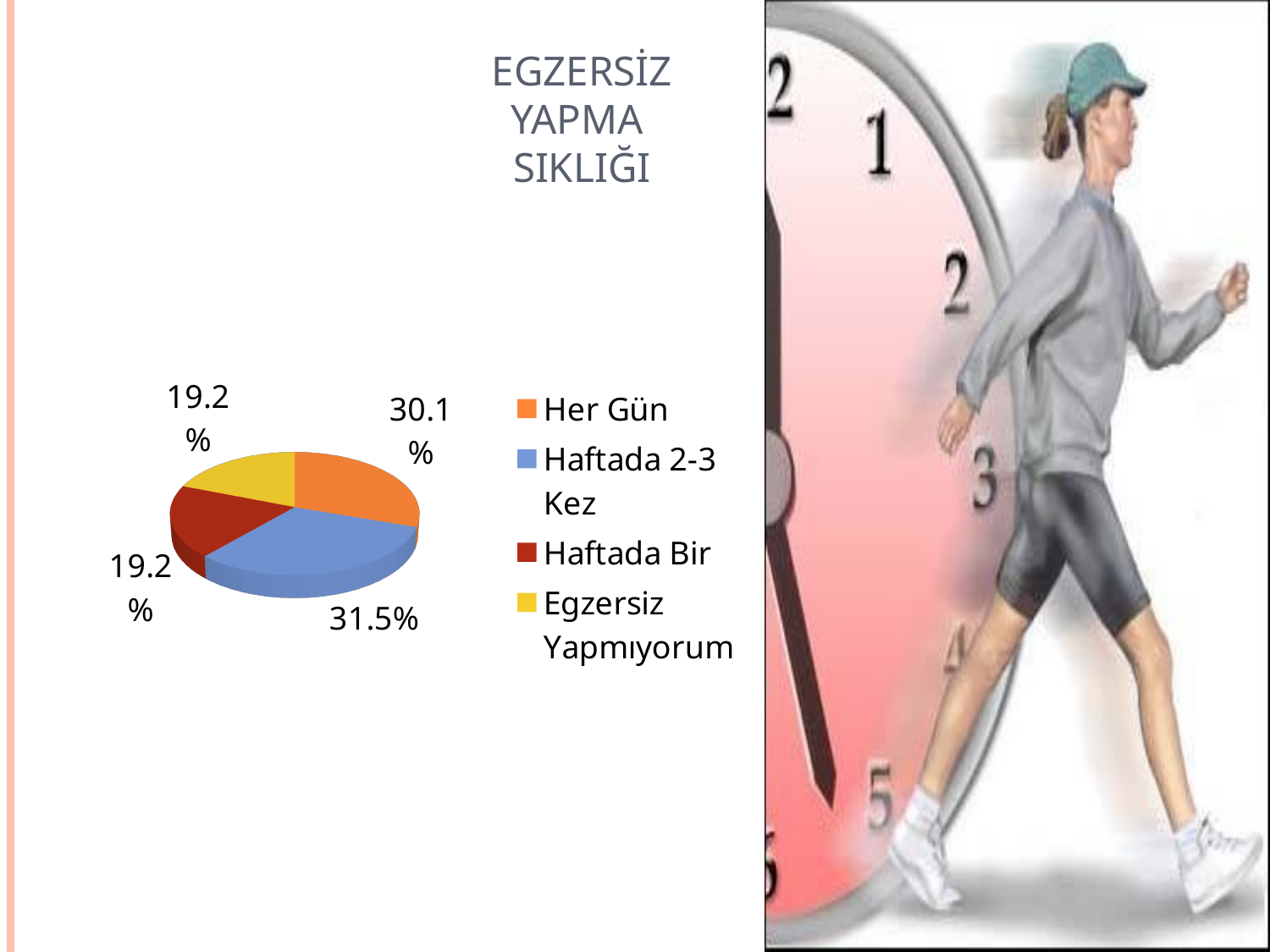
What is the title of the chart? EGZERSİZ YAPMA SIKLIĞI What percentage is shown for "Egzersiz Yapmıyorum"? 19.2% What percentage is shown for "Haftada 2-3 Kez"? 31.5% What percentage is shown for "Her Gün"? 30.1% What kind of chart is shown on the slide? Pie chart Which is larger, the share for "Her Gün" or the share for "Haftada 2-3 Kez"? Haftada 2-3 Kez Which category has the largest share of the pie? Haftada 2-3 Kez What percentage is shown for "Haftada Bir"? 19.2% What is the difference between the shares for "Haftada 2-3 Kez" and "Her Gün"? 1.4% Which colour represents "Egzersiz Yapmıyorum" in the legend? Yellow How many entries does the legend list? 4 How many slices does the pie chart have? 4